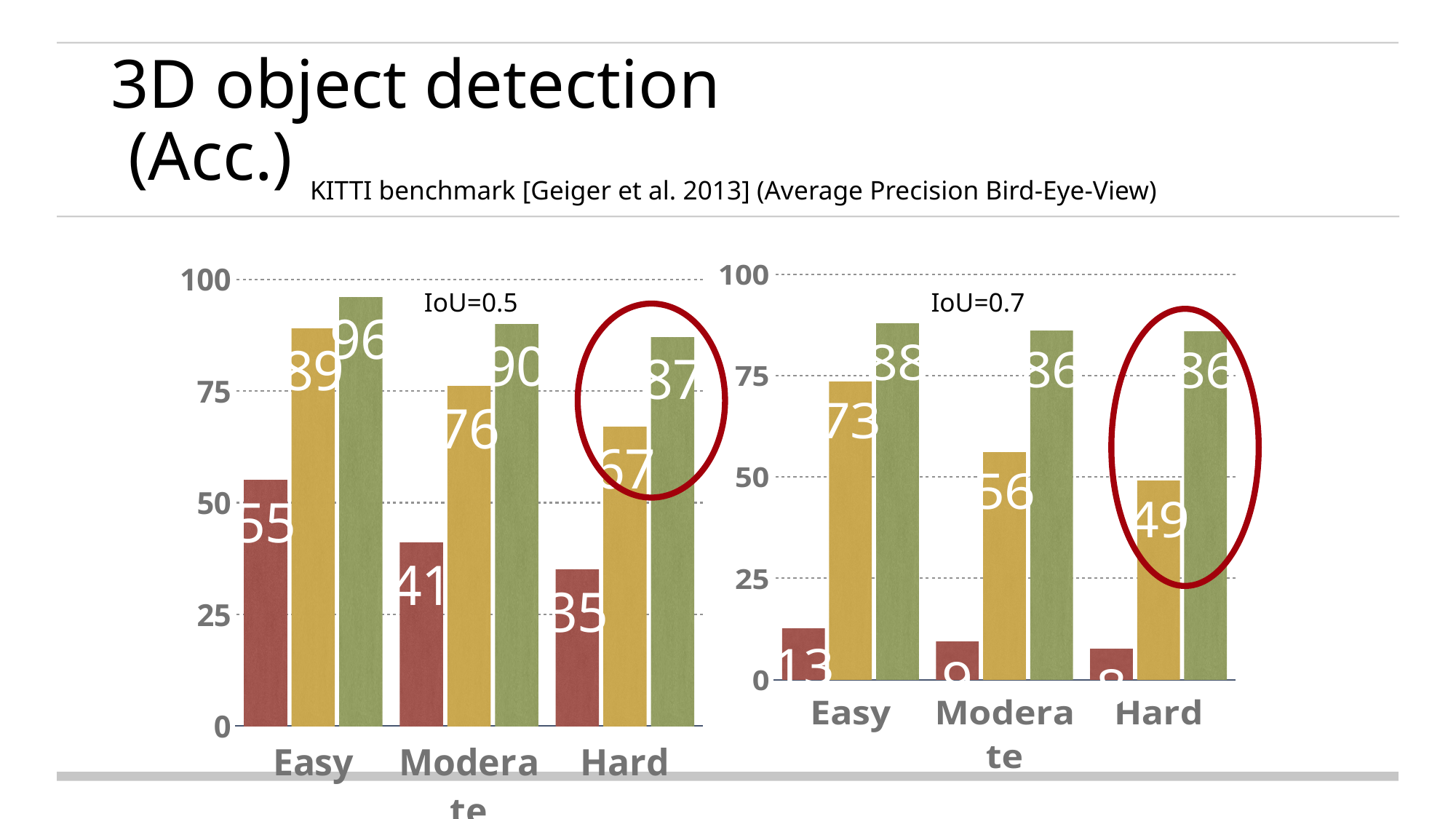
In the IoU=0.7 chart, is the yellow bar for Easy larger than the yellow bar for Moderate? Yes In the IoU=0.5 chart, what is the value of the green bar for Easy? 96 In the IoU=0.5 chart, what is the value of the red bar for Hard? 35 In the IoU=0.5 chart, which category has the highest green bar? Easy What type of chart is the IoU=0.7 chart? Bar chart In the IoU=0.5 chart, do the red bar values rise or fall from Easy to Hard? Fall In the IoU=0.5 chart, what is the difference between the green and yellow bars for Hard? 20 In the IoU=0.7 chart, what is the value of the yellow bar for Moderate? 56 In the IoU=0.7 chart, what is the difference between the green and yellow bars for Hard? 37 In the IoU=0.7 chart, which category has the lowest red bar? Hard How many categories are shown on the x axis of the IoU=0.5 chart? 3 In the IoU=0.7 chart, what is the value of the red bar for Easy? 13